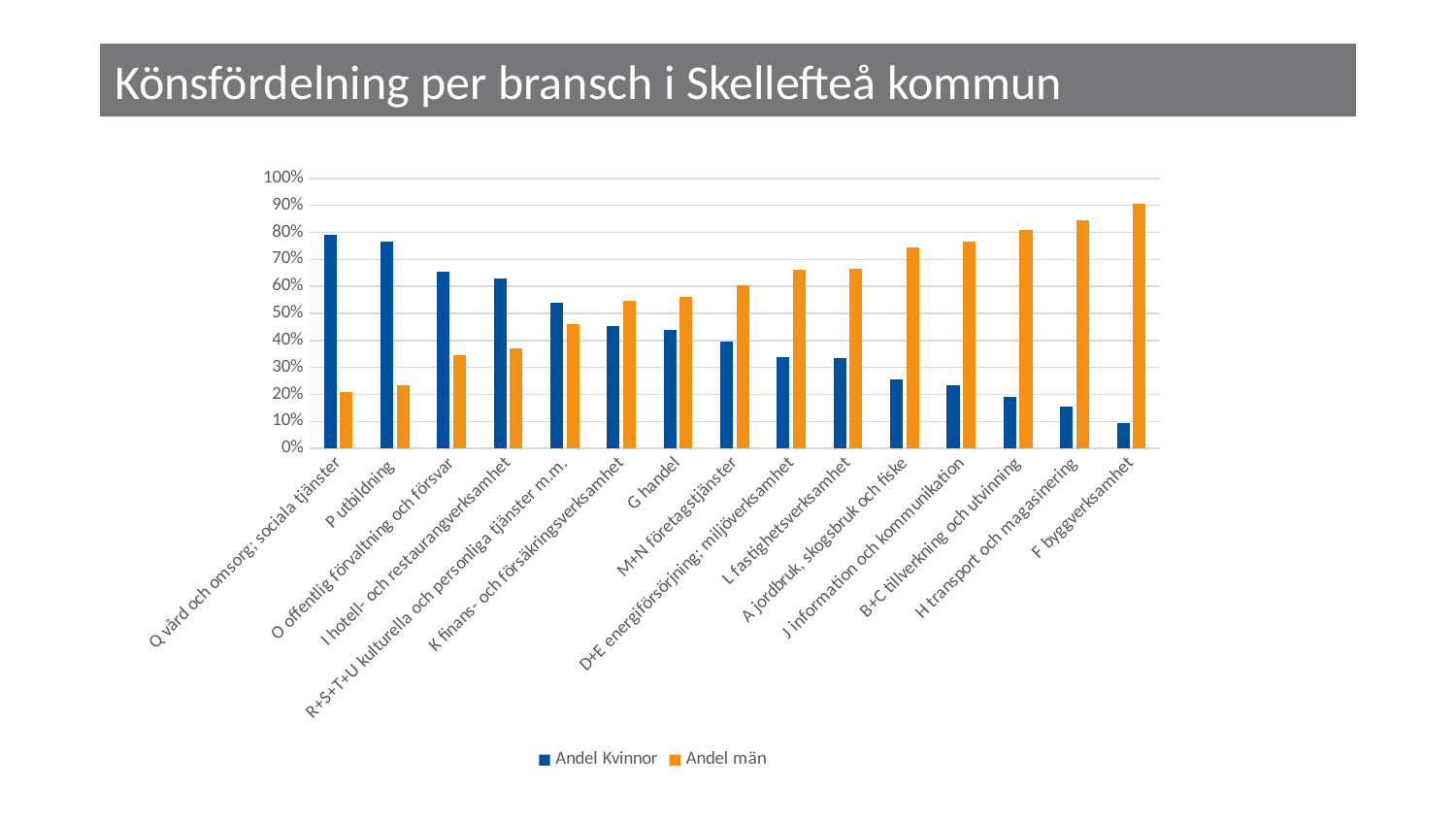
Do the Andel Kvinnor values rise or fall from left to right along the x axis? fall Is the Andel Kvinnor value for P utbildning greater or less than 70%? greater How many industry categories are shown on the x axis? 15 What are the two series named in the legend? Andel Kvinnor and Andel män Is the Andel män value for H transport och magasinering greater or less than 80%? greater Which category has the highest value for Andel män? F byggverksamhet Is the Andel män value for Q vård och omsorg; sociala tjänster greater or less than 30%? less Which category has the lowest value for Andel Kvinnor? F byggverksamhet For G handel, which is larger: Andel Kvinnor or Andel män? Andel män Which category has the highest value for Andel Kvinnor? Q vård och omsorg; sociala tjänster What kind of chart is shown on the slide? Bar chart How many series does the legend list? 2